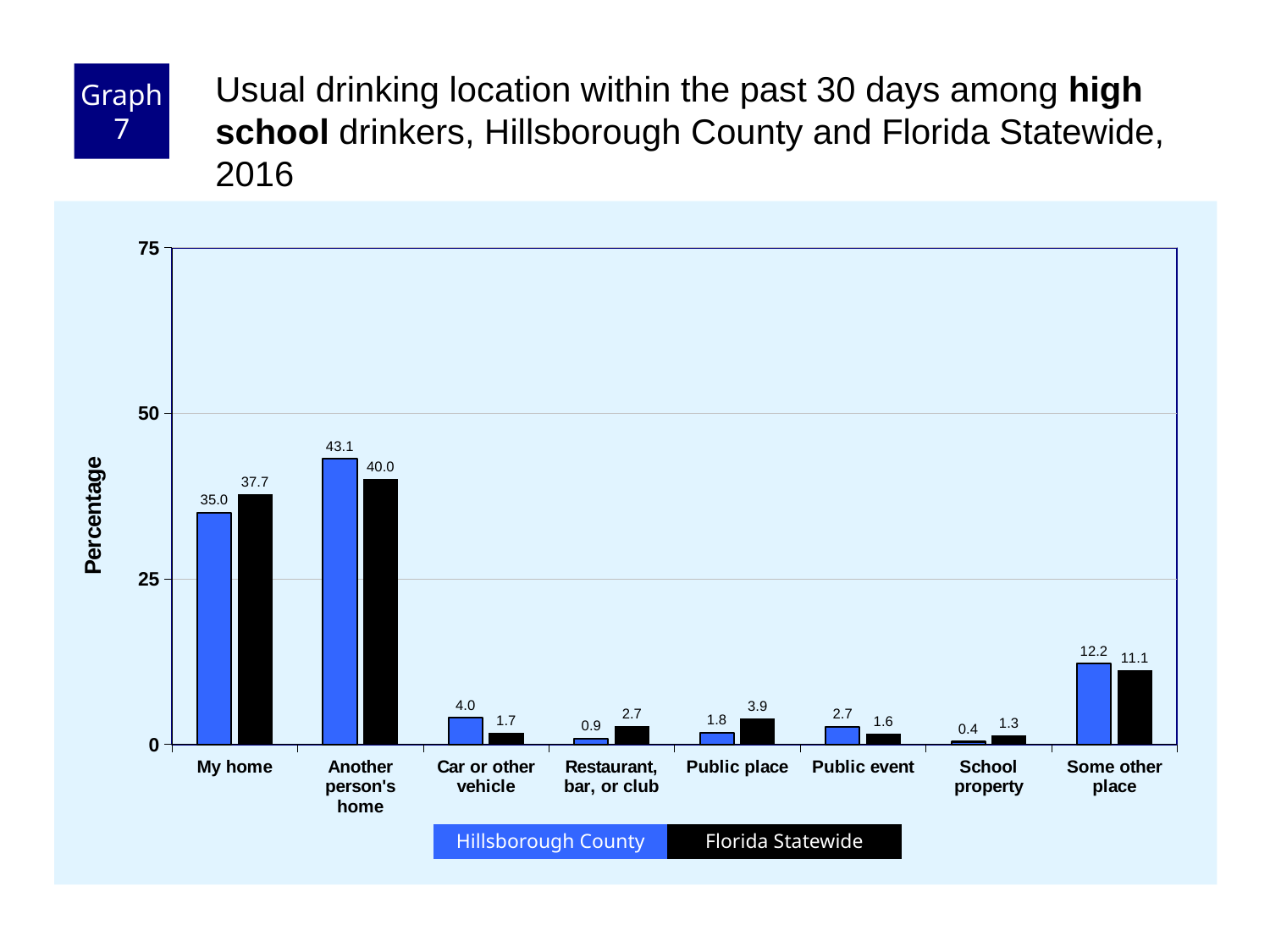
What is the label of the y axis? Percentage How many categories are shown on the x axis? 8 What is the Hillsborough County value for "Another person's home"? 43.1 What is the Florida Statewide value for "My home"? 37.7 What is the Hillsborough County value for "Some other place"? 12.2 What is the difference between the Hillsborough County and Florida Statewide values for "Another person's home"? 3.1 Which is larger for "Public place": Hillsborough County or Florida Statewide? Florida Statewide Which category has the highest Florida Statewide value? Another person's home Which category has the lowest Hillsborough County value? School property How many series does the legend list? 2 What kind of chart is shown on the slide? Bar chart Is the Hillsborough County value for "My home" greater or less than 25? greater